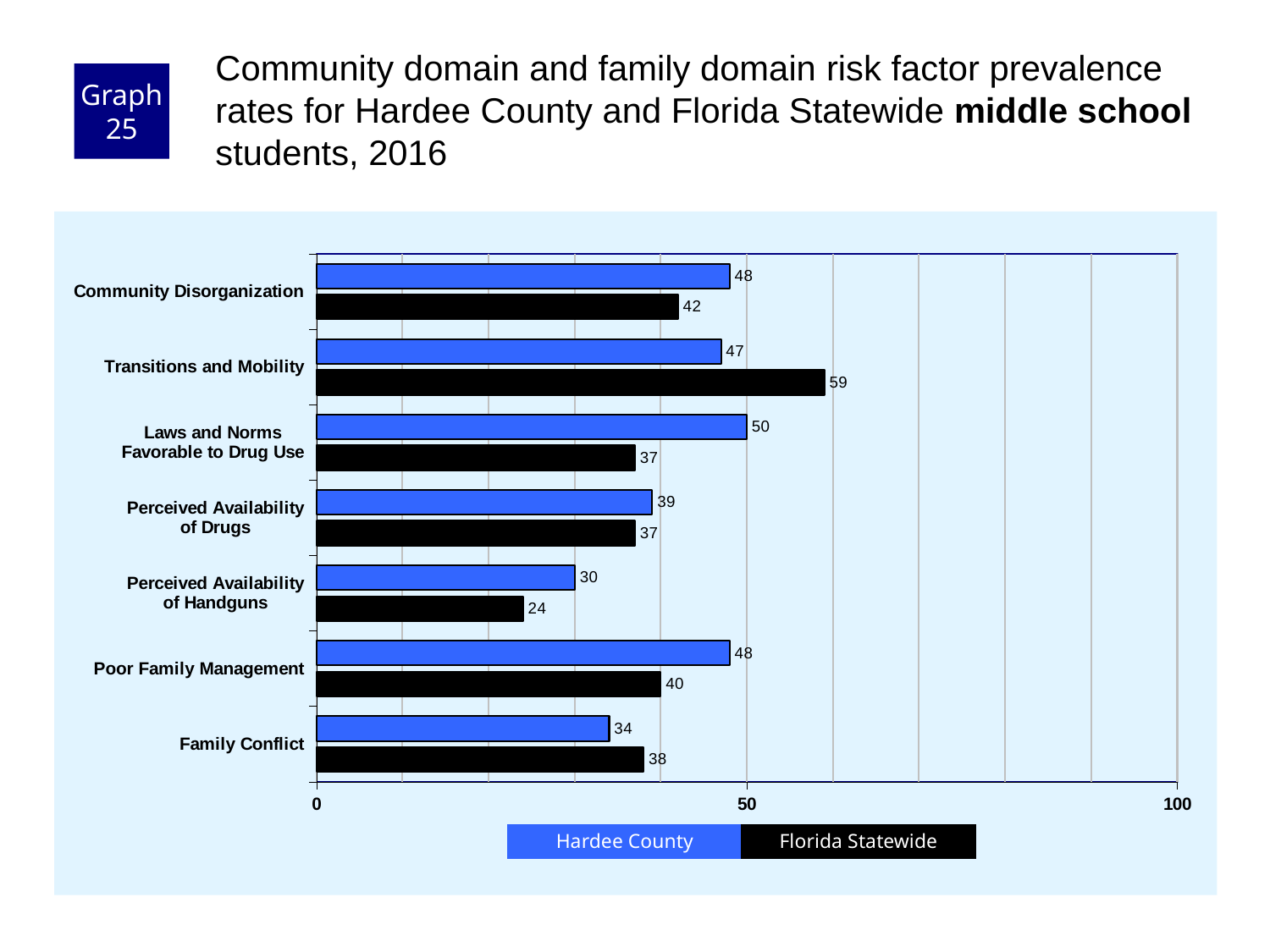
What is the Hardee County value for Laws and Norms Favorable to Drug Use? 50 Which is larger for Poor Family Management: the Hardee County value or the Florida Statewide value? Hardee County What kind of chart is shown on the slide? Bar chart How many series does the legend list? 2 What is the Florida Statewide value for Perceived Availability of Handguns? 24 Which is larger for Family Conflict: the Hardee County value or the Florida Statewide value? Florida Statewide Which category has the highest Florida Statewide value? Transitions and Mobility Which category has the lowest Hardee County value? Perceived Availability of Handguns How many risk factor categories are shown on the chart? 7 What is the difference between the Florida Statewide and Hardee County values for Transitions and Mobility? 12 What is the difference between the Hardee County and Florida Statewide values for Laws and Norms Favorable to Drug Use? 13 What is the Hardee County value for Transitions and Mobility? 47